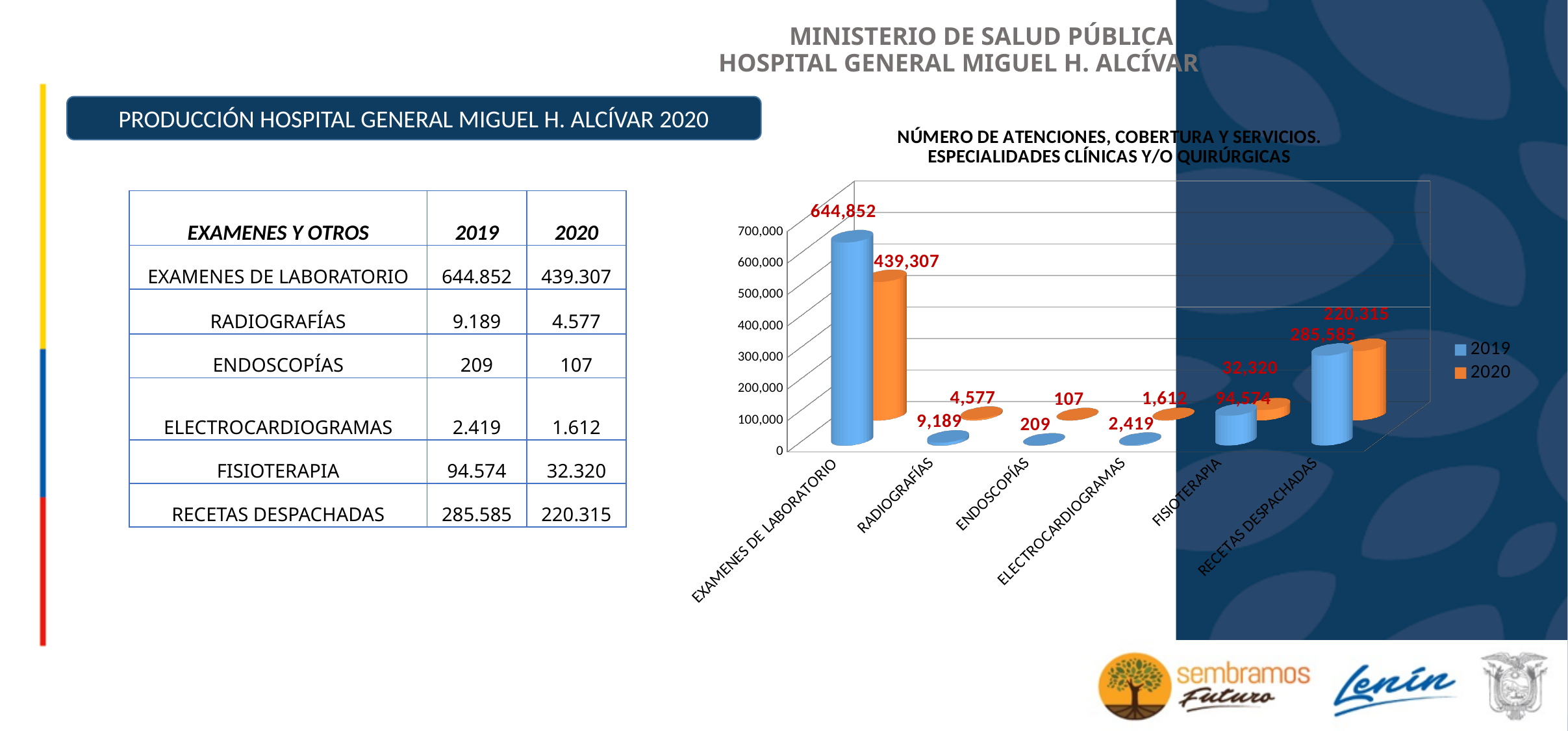
What is the 2019 value for ENDOSCOPÍAS in the chart? 209 Which is larger for FISIOTERAPIA: the 2019 value or the 2020 value? 2019 How many categories are shown on the x axis of the chart? 6 What is the difference between the 2019 and 2020 values for EXAMENES DE LABORATORIO? 205,545 What is the difference between the 2019 and 2020 values for RECETAS DESPACHADAS? 65,270 What is the 2019 value for EXAMENES DE LABORATORIO in the chart? 644,852 What is the 2020 value for RECETAS DESPACHADAS in the chart? 220,315 How many series does the chart legend list? 2 Which category has the lowest 2020 value in the chart? ENDOSCOPÍAS What is the 2020 value for FISIOTERAPIA in the chart? 32,320 What type of chart is shown on the slide? Bar chart Which category has the highest 2019 value in the chart? EXAMENES DE LABORATORIO